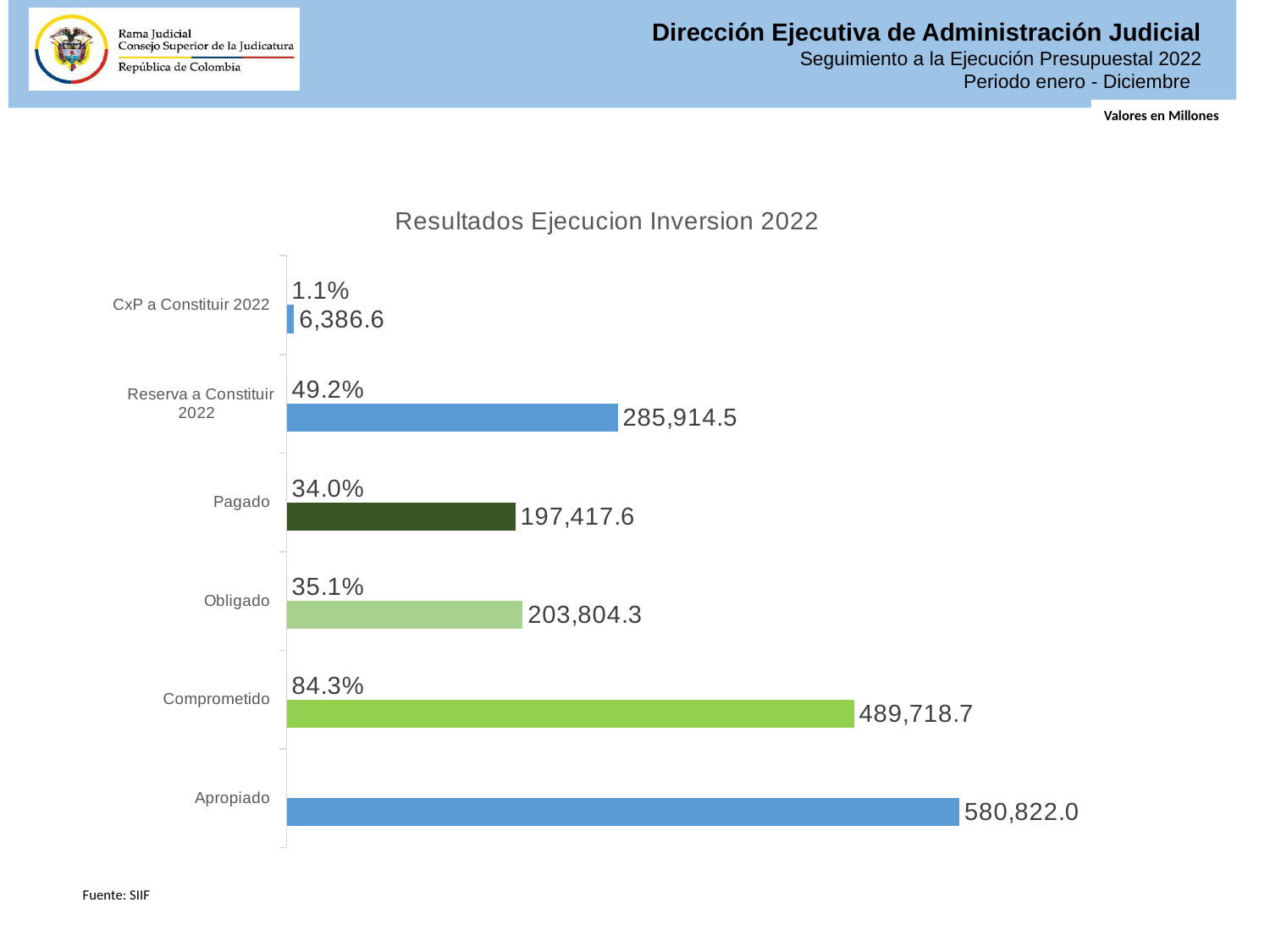
Which category has the highest value in the chart? Apropiado What is the value for Comprometido in the chart? 489,718.7 What percentage is shown for Reserva a Constituir 2022? 49.2% Which is larger, the value for Reserva a Constituir 2022 or the value for Obligado? Reserva a Constituir 2022 What is the value for Pagado in the chart? 197,417.6 What type of chart is shown on the slide? Bar chart What is the difference between the values for Apropiado and Comprometido? 91,103.3 How many categories are shown in the chart? 6 What is the value for Apropiado in the chart? 580,822.0 What percentage is shown for CxP a Constituir 2022? 1.1% What is the difference between the values for Obligado and Pagado? 6,386.7 Which category has the lowest value in the chart? CxP a Constituir 2022